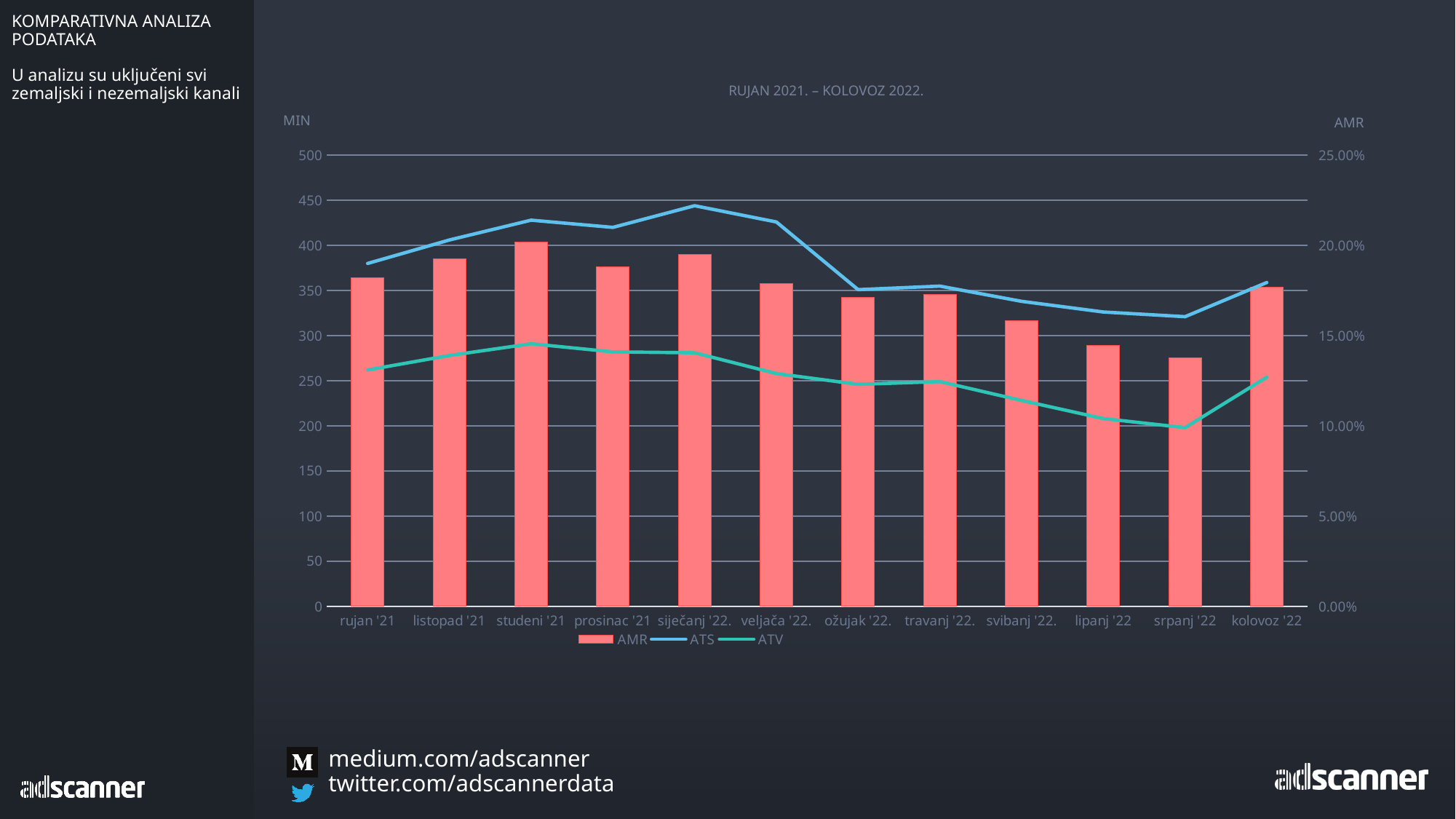
How many months are shown on the x axis of the chart? 12 What is the title of the chart? RUJAN 2021. – KOLOVOZ 2022. In which month does the ATV line reach its lowest point? srpanj '22 Does the ATS line rise or fall from siječanj '22. to srpanj '22? fall Which month has the lowest AMR bar? srpanj '22 Is the ATS value for srpanj '22 greater or less than 350 on the MIN axis? less How many series does the chart legend list? 3 Which month has the larger AMR bar, rujan '21 or listopad '21? listopad '21 What kind of chart is shown on the slide? Combined bar and line chart Is the ATS value for siječanj '22. greater or less than 400 on the MIN axis? greater Which month has the highest AMR bar? studeni '21 In which month does the ATS line reach its highest point? siječanj '22.